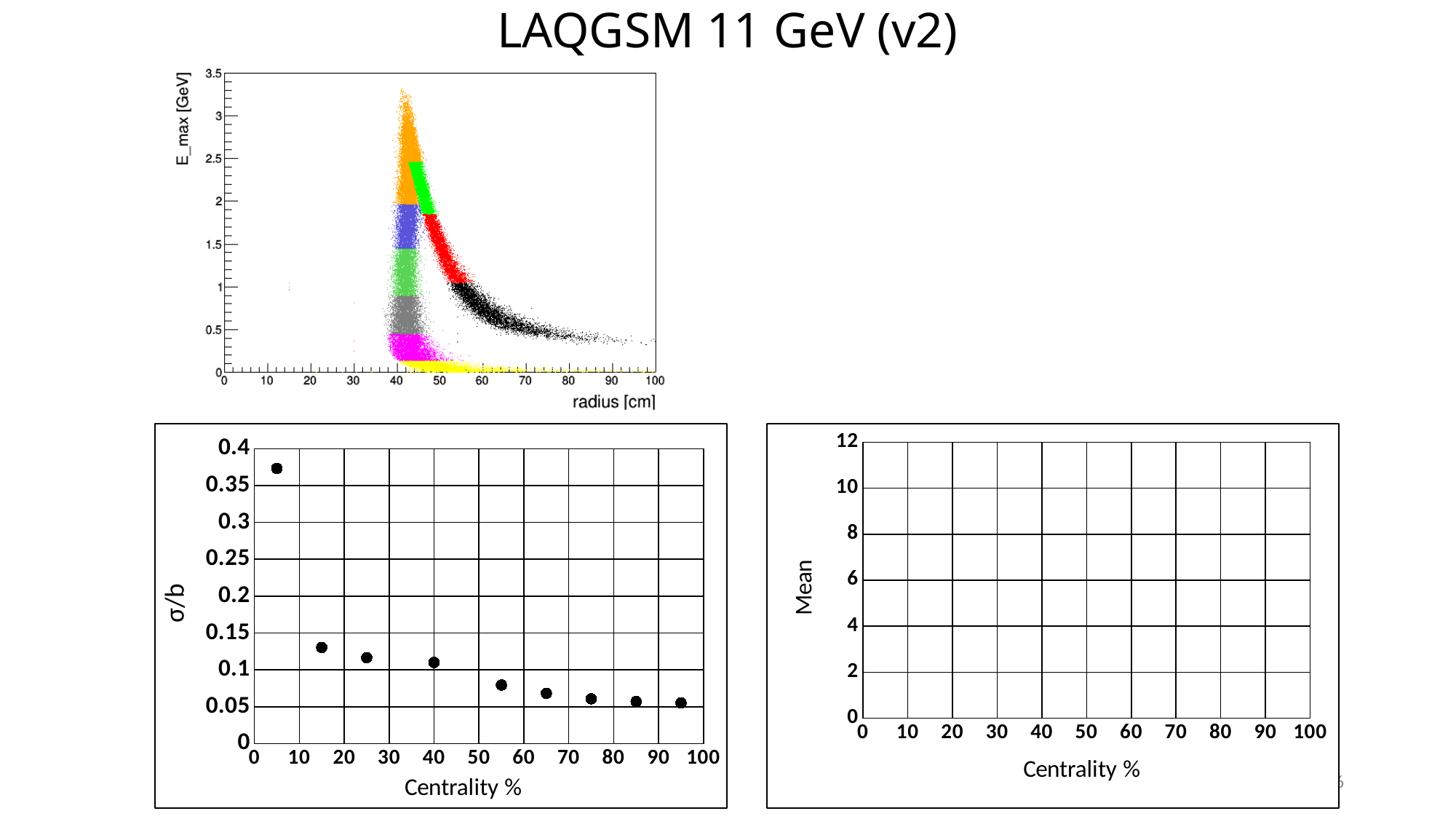
In the σ/b vs Centrality % chart (bottom left), at which centrality value is σ/b highest? 5 In the σ/b vs Centrality % chart (bottom left), is the σ/b value at centrality 5 greater or less than 0.35? greater In the σ/b vs Centrality % chart (bottom left), which has the larger σ/b value: centrality 5 or centrality 15? centrality 5 In the σ/b vs Centrality % chart (bottom left), is the σ/b value at centrality 55 greater or less than 0.1? less What kind of chart is the σ/b vs Centrality % chart (bottom left)? scatter chart What is the x-axis label of the top chart? radius [cm] In the σ/b vs Centrality % chart (bottom left), how many data points are plotted? 9 In the σ/b vs Centrality % chart (bottom left), which has the larger σ/b value: centrality 15 or centrality 55? centrality 15 In the σ/b vs Centrality % chart (bottom left), is the σ/b value at centrality 15 greater or less than 0.15? less What is the y-axis label of the bottom right chart? Mean In the σ/b vs Centrality % chart (bottom left), do the σ/b values rise or fall as centrality increases? fall